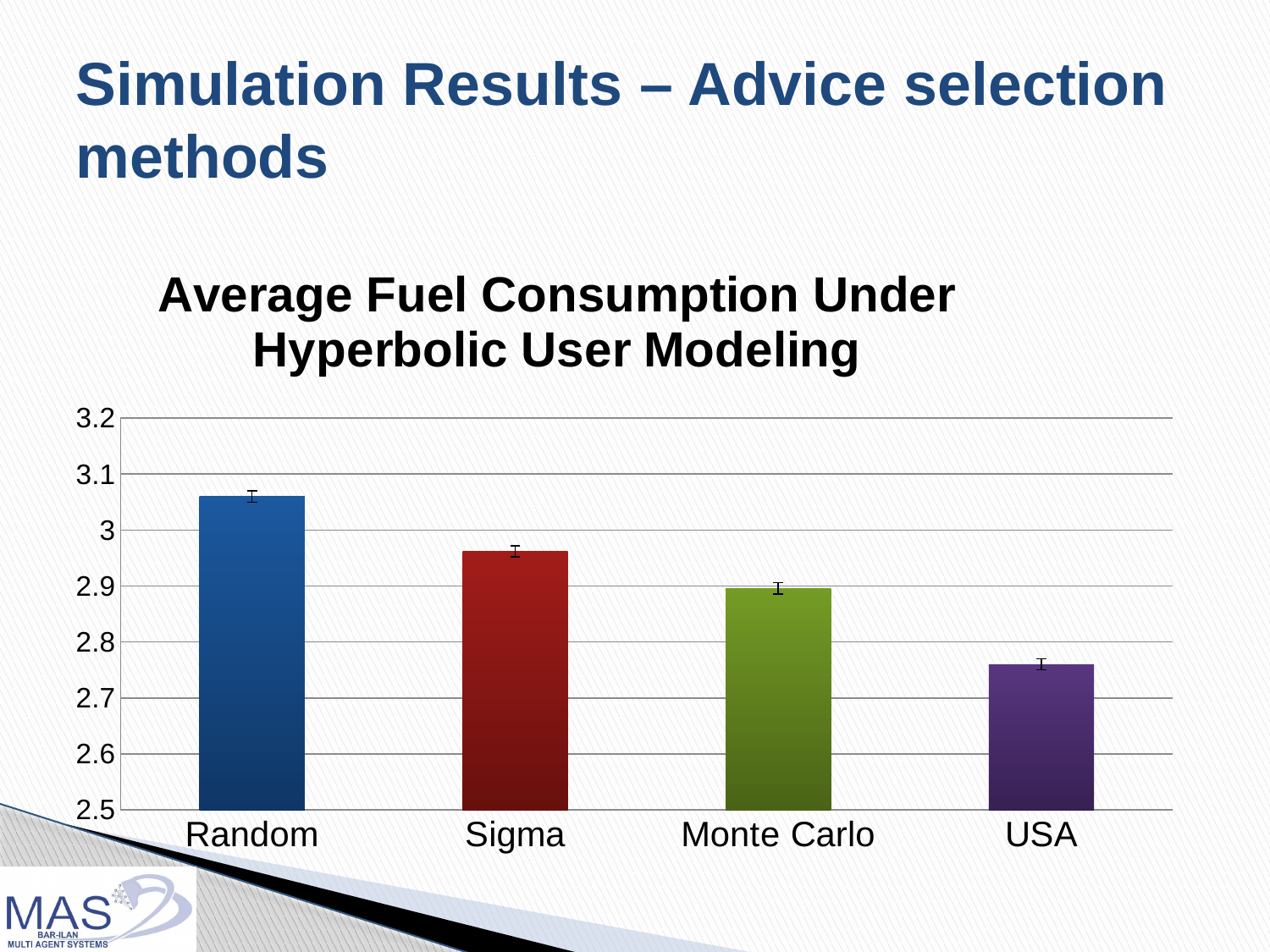
Which method has the highest average fuel consumption? Random Is the value for USA greater or less than 2.8? less Which method has the lowest average fuel consumption? USA Is the value for Random greater or less than 3? greater What kind of chart is shown on the slide? bar chart Is the value for Monte Carlo greater or less than 2.8? greater How many advice selection methods are plotted on the x axis? 4 What is the title of the chart? Average Fuel Consumption Under Hyperbolic User Modeling Do the bar values rise or fall from left to right across the x axis? fall What is the lowest value shown on the vertical axis? 2.5 Which has a higher average fuel consumption, Sigma or USA? Sigma